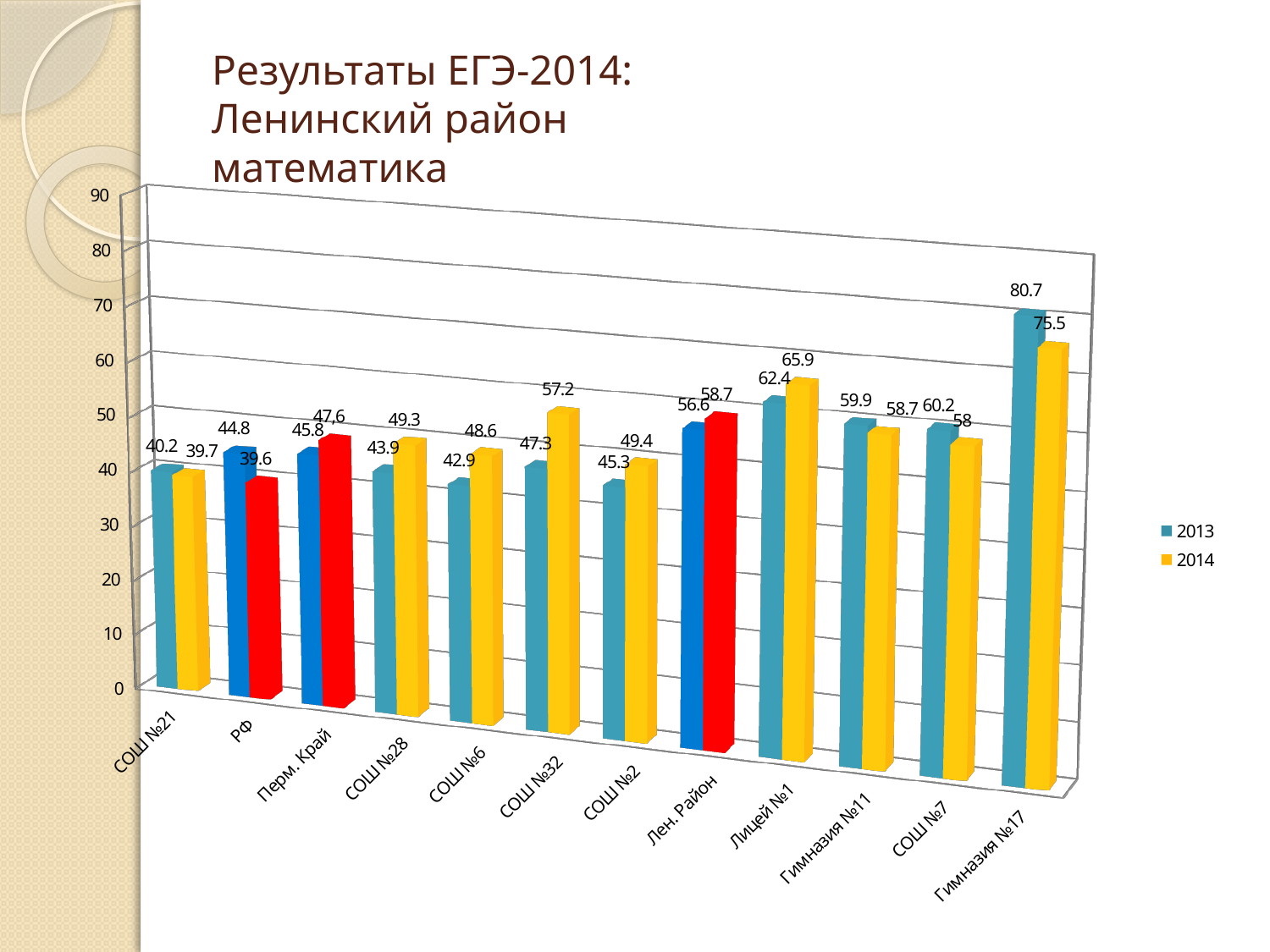
What is the 2014 value for СОШ №32? 57.2 How many series does the legend list? 2 Which category has the lowest 2014 value? РФ Is the 2014 value for Лен. Район greater or less than 50? greater How many categories are shown on the x axis? 12 Which category has the highest 2013 value? Гимназия №17 What is the difference between the 2013 and 2014 values for Гимназия №17? 5.2 What is the 2014 value for РФ? 39.6 Which is larger for СОШ №28: the 2013 value or the 2014 value? 2014 What is the 2013 value for Лицей №1? 62.4 What type of chart is shown on the slide? bar chart What is the title of the chart on the slide? Результаты ЕГЭ-2014: Ленинский район математика